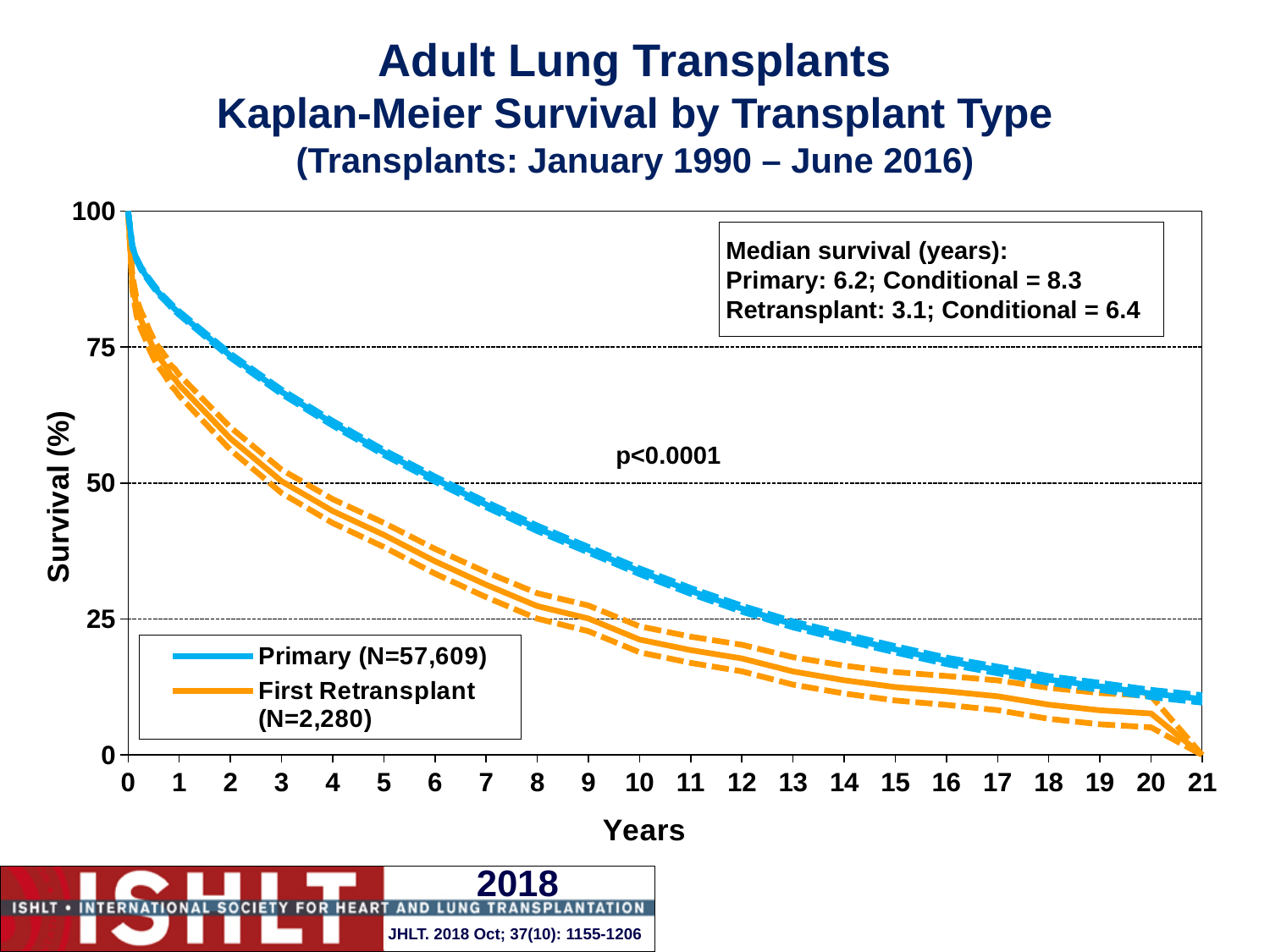
What kind of chart is shown on the slide? Line chart What p-value is printed on the chart? p<0.0001 Is the survival for Primary at 5 years greater or less than 50? greater How many series does the legend list? 2 Which series has higher survival at 10 years, Primary or First Retransplant? Primary Is the survival for First Retransplant at 5 years greater or less than 50? less What is the difference in median survival (years) between Primary and Retransplant? 3.1 What is the median survival in years for Retransplant? 3.1 What is the N for the Primary series in the legend? 57,609 Do the survival curves rise or fall as years increase? Fall What is the conditional median survival in years for Primary transplants? 8.3 What is the median survival in years for Primary transplants? 6.2